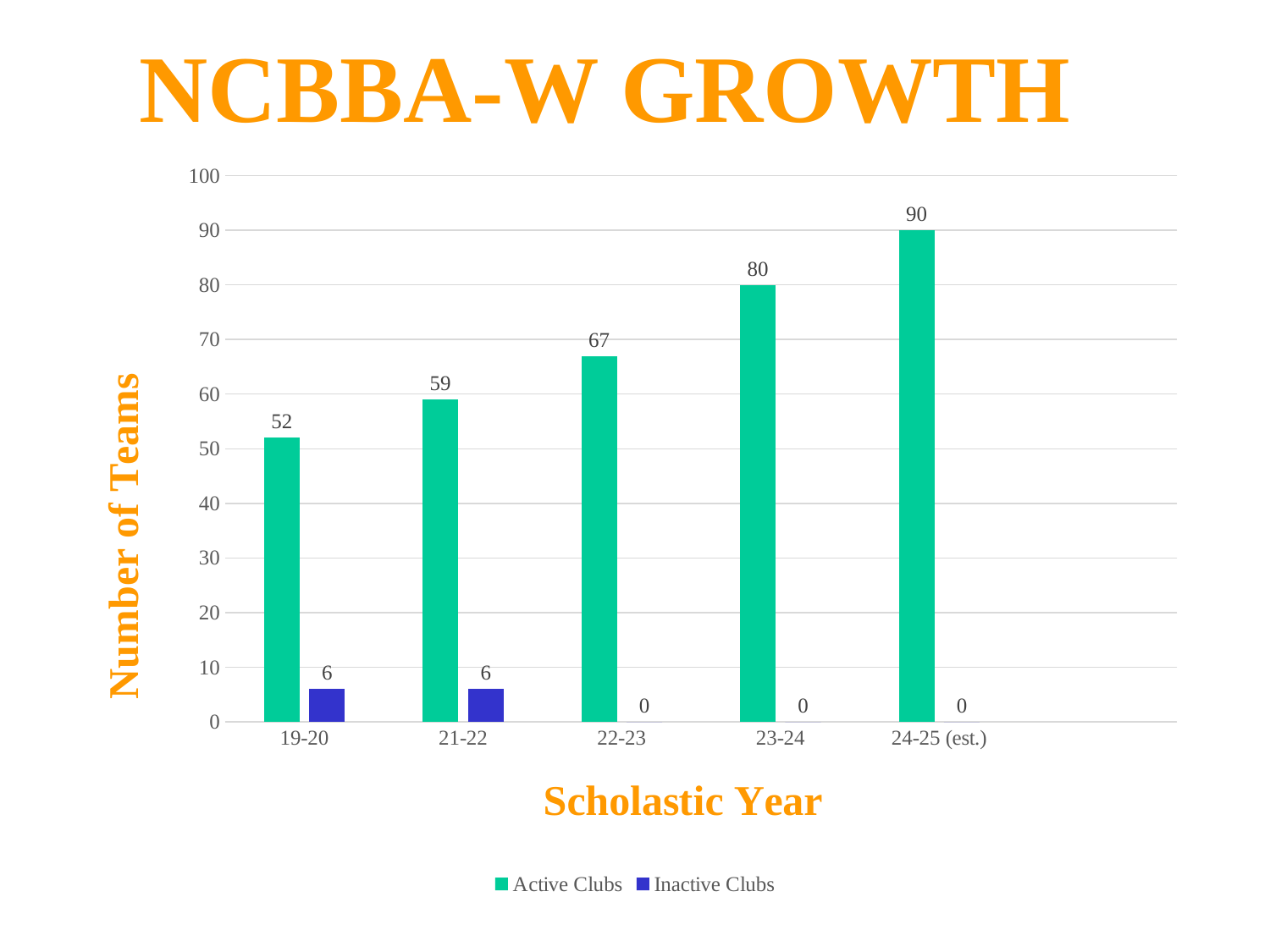
What kind of chart is shown on the slide? Bar chart Do the Active Clubs values rise or fall from 19-20 to 24-25 (est.)? Rise How many Active Clubs were there in 22-23? 67 What is the label of the y axis? Number of Teams How many scholastic years are shown on the x axis? 5 What is the difference in Active Clubs between 23-24 and 19-20? 28 What is the estimated number of Active Clubs for 24-25 (est.)? 90 Which is larger, the number of Active Clubs in 21-22 or in 22-23? 22-23 How many Inactive Clubs were there in 21-22? 6 Which scholastic year has the highest number of Active Clubs? 24-25 (est.) How many series does the legend list? 2 Which scholastic year has the lowest number of Active Clubs? 19-20